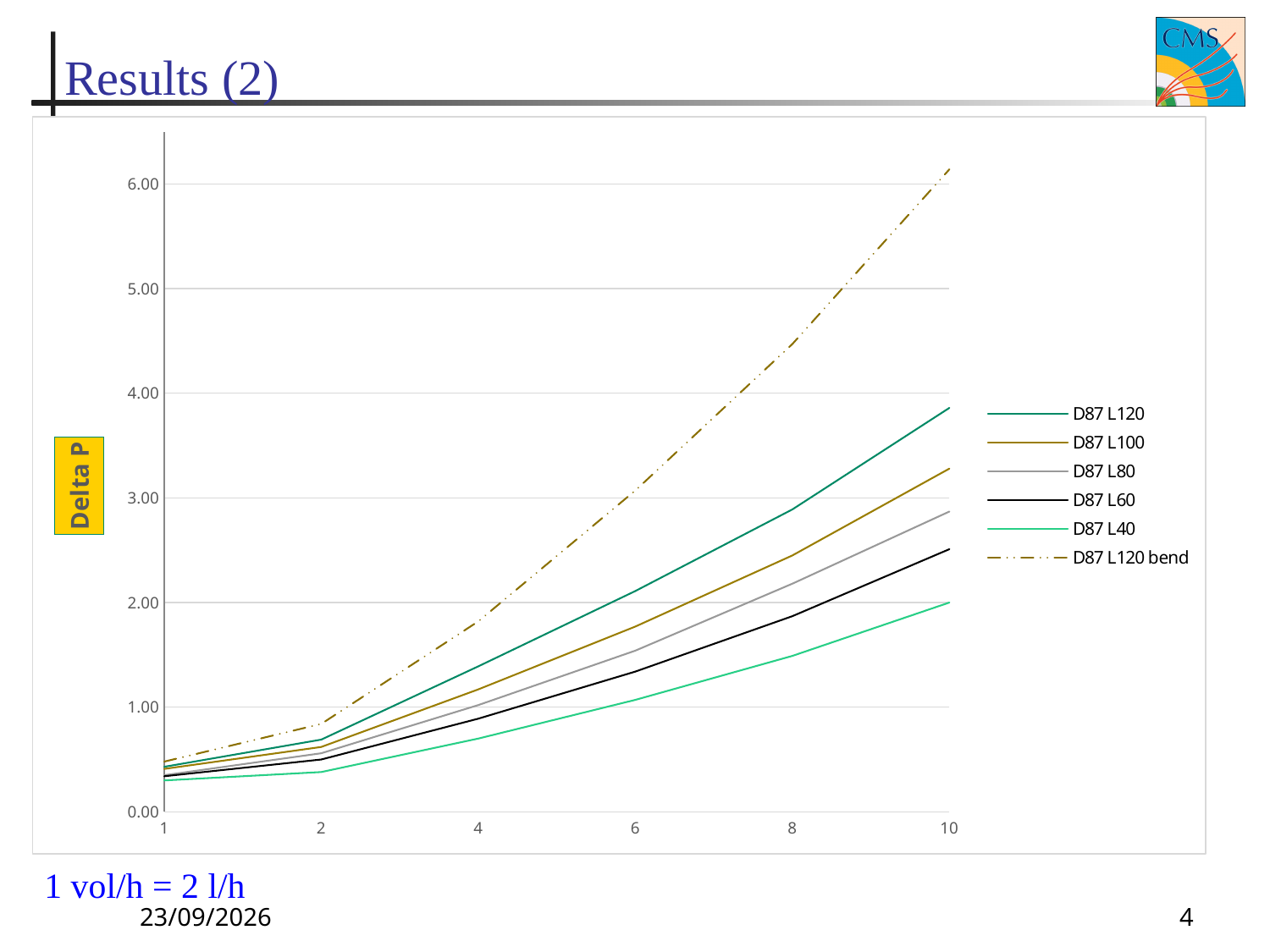
Do the values of the D87 L120 series rise or fall as x increases from 1 to 10? rise What is the title of the y axis? Delta P What kind of chart is shown on the slide? line chart Which series has the lowest value at x = 10? D87 L40 How many tick labels are shown on the x axis? 6 Is the value for D87 L80 at x = 10 greater or less than 3.00? less At x = 10, which is larger: the value for D87 L100 or the value for D87 L60? D87 L100 Which series has the highest value at x = 10? D87 L120 bend Which series is drawn with a dashed line? D87 L120 bend Is the value for D87 L120 at x = 10 greater or less than 3.00? greater Is the value for D87 L120 bend at x = 10 greater or less than 5.00? greater How many series does the legend list? 6